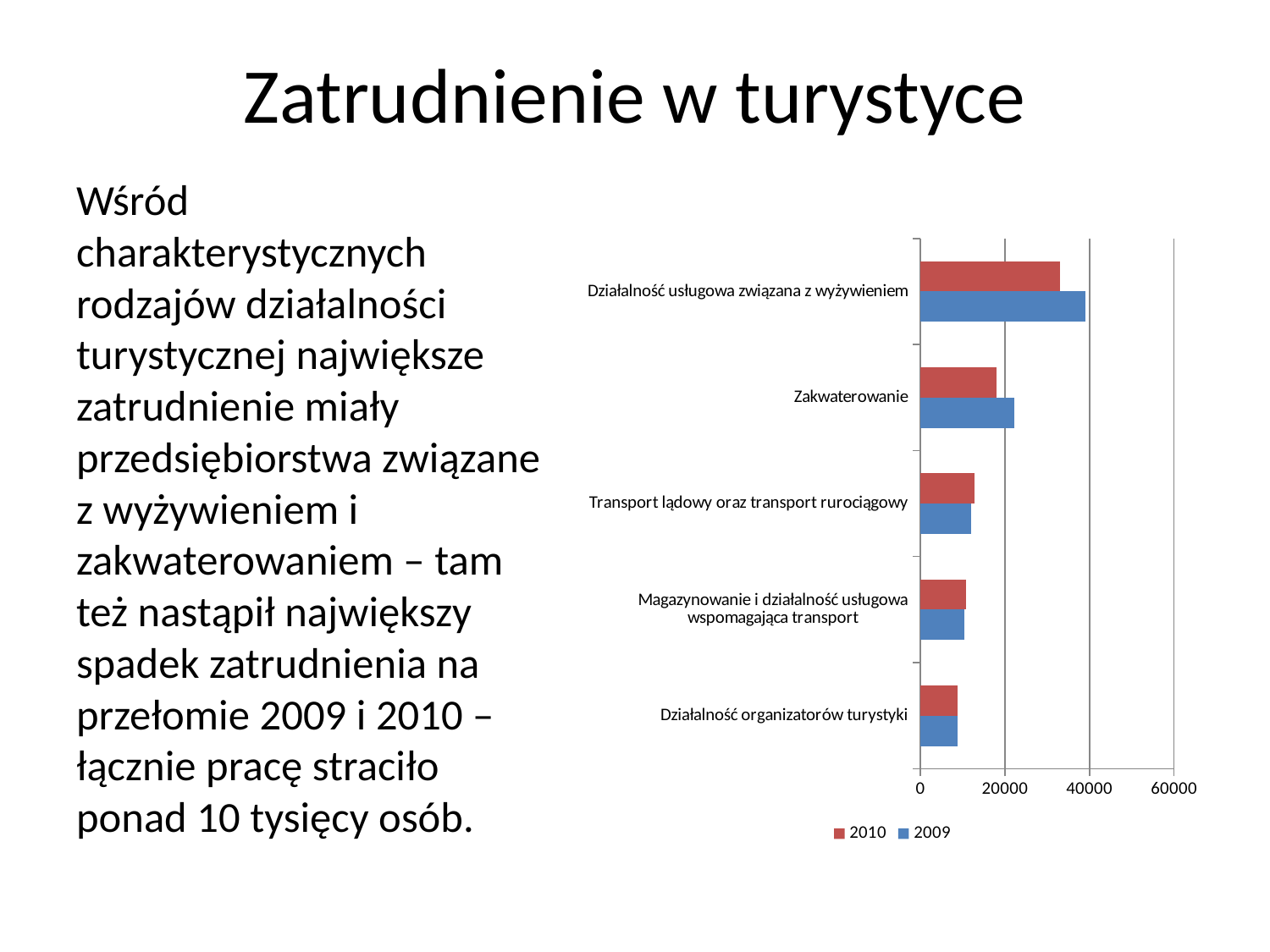
How many categories are shown on the chart? 5 Which category has the highest value for 2010? Działalność usługowa związana z wyżywieniem Which category has the lowest value for 2009? Działalność organizatorów turystyki What kind of chart is shown on the slide? bar chart Is the 2009 value for Zakwaterowanie greater or less than 40000? less Is the 2009 value for Działalność usługowa związana z wyżywieniem greater or less than 20000? greater Which category has the highest value for 2009? Działalność usługowa związana z wyżywieniem For Działalność usługowa związana z wyżywieniem, which year has the larger value, 2009 or 2010? 2009 Which colour represents the 2010 series in the legend? red For Zakwaterowanie, which year has the larger value, 2009 or 2010? 2009 How many series does the legend list? 2